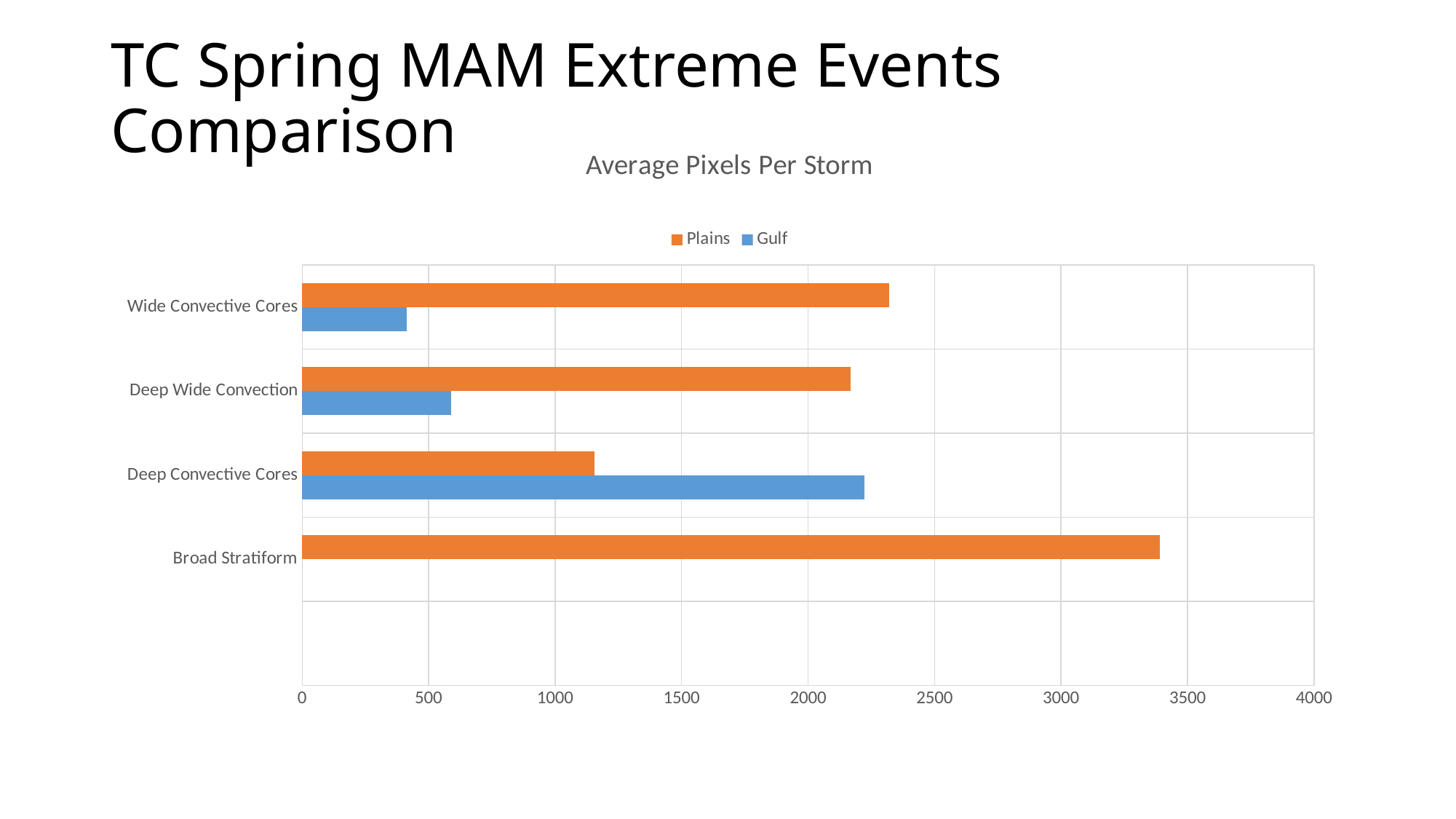
Which colour represents the Gulf series in the chart? Blue Which category has the highest Plains value? Broad Stratiform For Deep Convective Cores, which is larger, the Plains value or the Gulf value? Gulf What kind of chart is shown on the slide? Bar chart How many categories are shown on the vertical axis of the chart? 4 Which category has the lowest Plains value? Deep Convective Cores How many series does the legend list? 2 What is the title of the chart? Average Pixels Per Storm Is the Gulf value for Wide Convective Cores greater or less than 500? less Which category has the highest Gulf value? Deep Convective Cores For Wide Convective Cores, which is larger, the Plains value or the Gulf value? Plains Is the Plains value for Broad Stratiform greater or less than 3000? greater